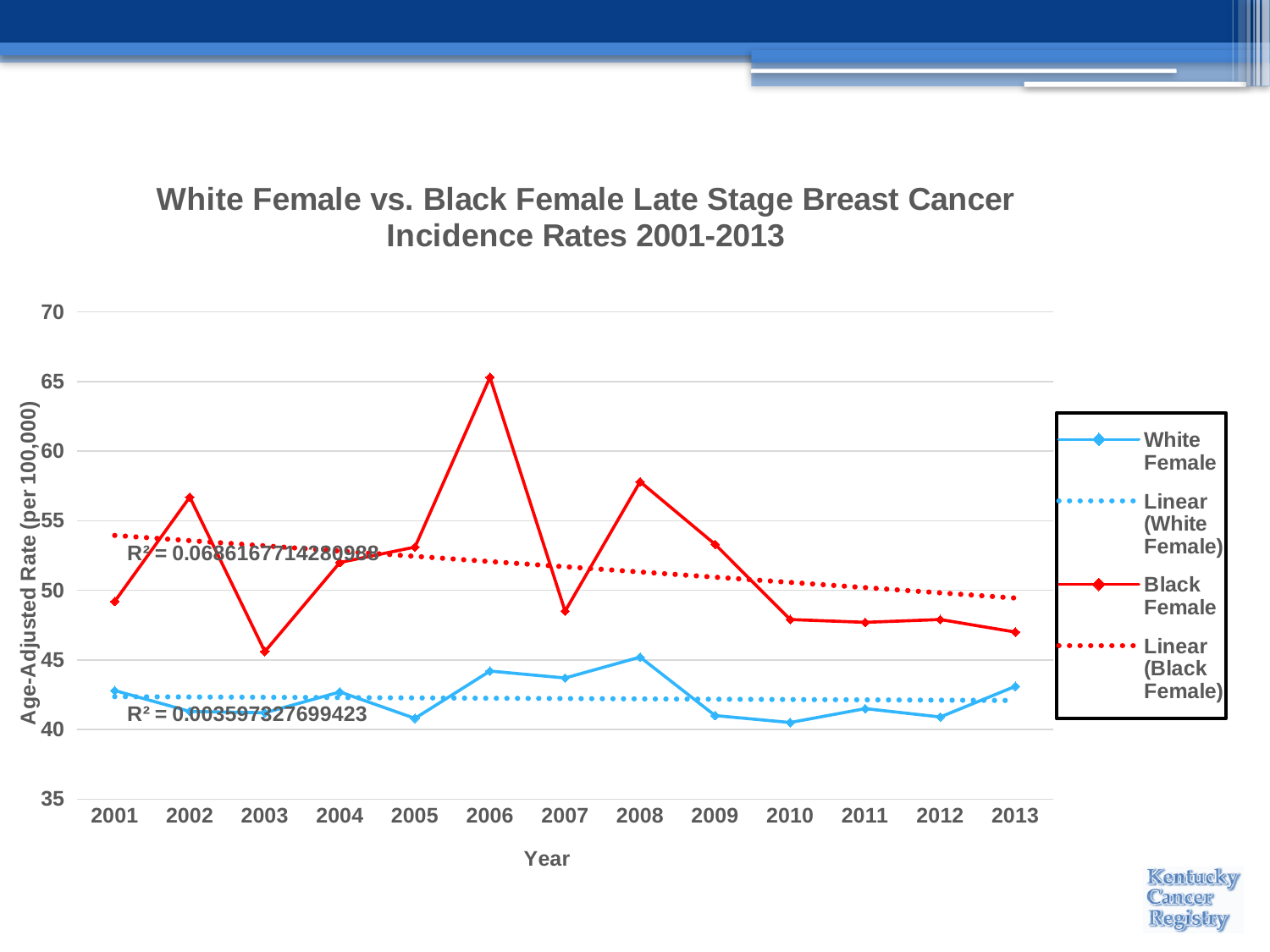
Which is larger, the White Female value for 2008 or for 2010? 2008 How many entries does the legend list? 4 In which year is the Black Female late stage breast cancer incidence rate lowest? 2003 In which year is the Black Female late stage breast cancer incidence rate highest? 2006 How many years are plotted along the x axis? 13 Is the Black Female value for 2003 greater or less than 50? less Is the White Female value for 2010 greater or less than 45? less Does the Linear (Black Female) trendline rise or fall from 2001 to 2013? fall Is the Black Female value for 2006 greater or less than 60? greater Which is larger, the Black Female value for 2006 or for 2008? 2006 What is the label of the y axis? Age-Adjusted Rate (per 100,000) What kind of chart is shown on the slide? line chart